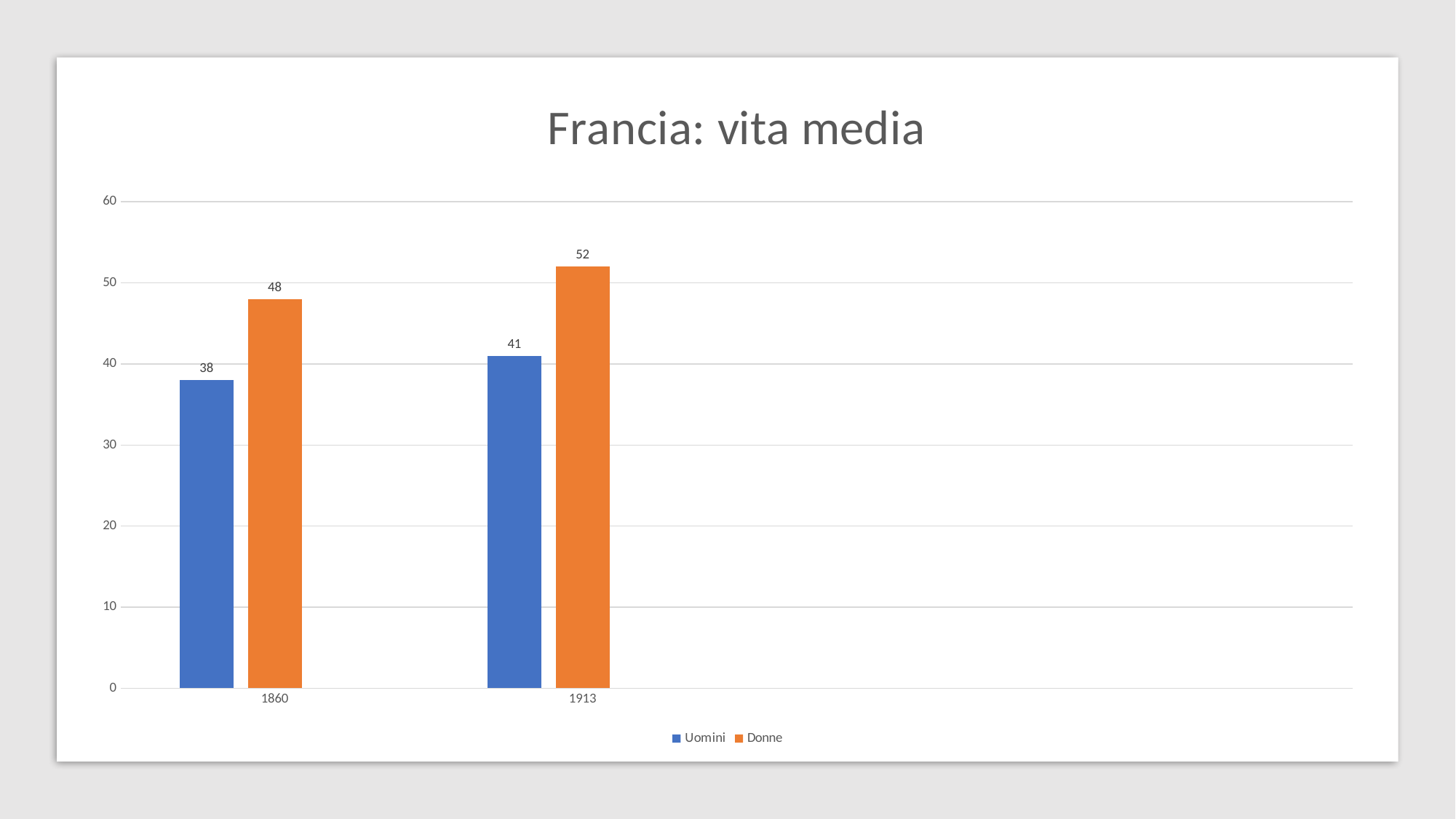
Which year has the lowest value for Uomini? 1860 What is the title of the chart? Francia: vita media What is the difference between Donne and Uomini in 1913? 11 Which is larger in 1860, Uomini or Donne? Donne Which year has the highest value for Donne? 1913 What is the value for Donne in 1913? 52 How many series does the legend list? 2 What is the value for Uomini in 1913? 41 What is the value for Donne in 1860? 48 What is the difference between the Donne values for 1913 and 1860? 4 What is the value for Uomini in 1860? 38 How many years are shown on the x axis? 2